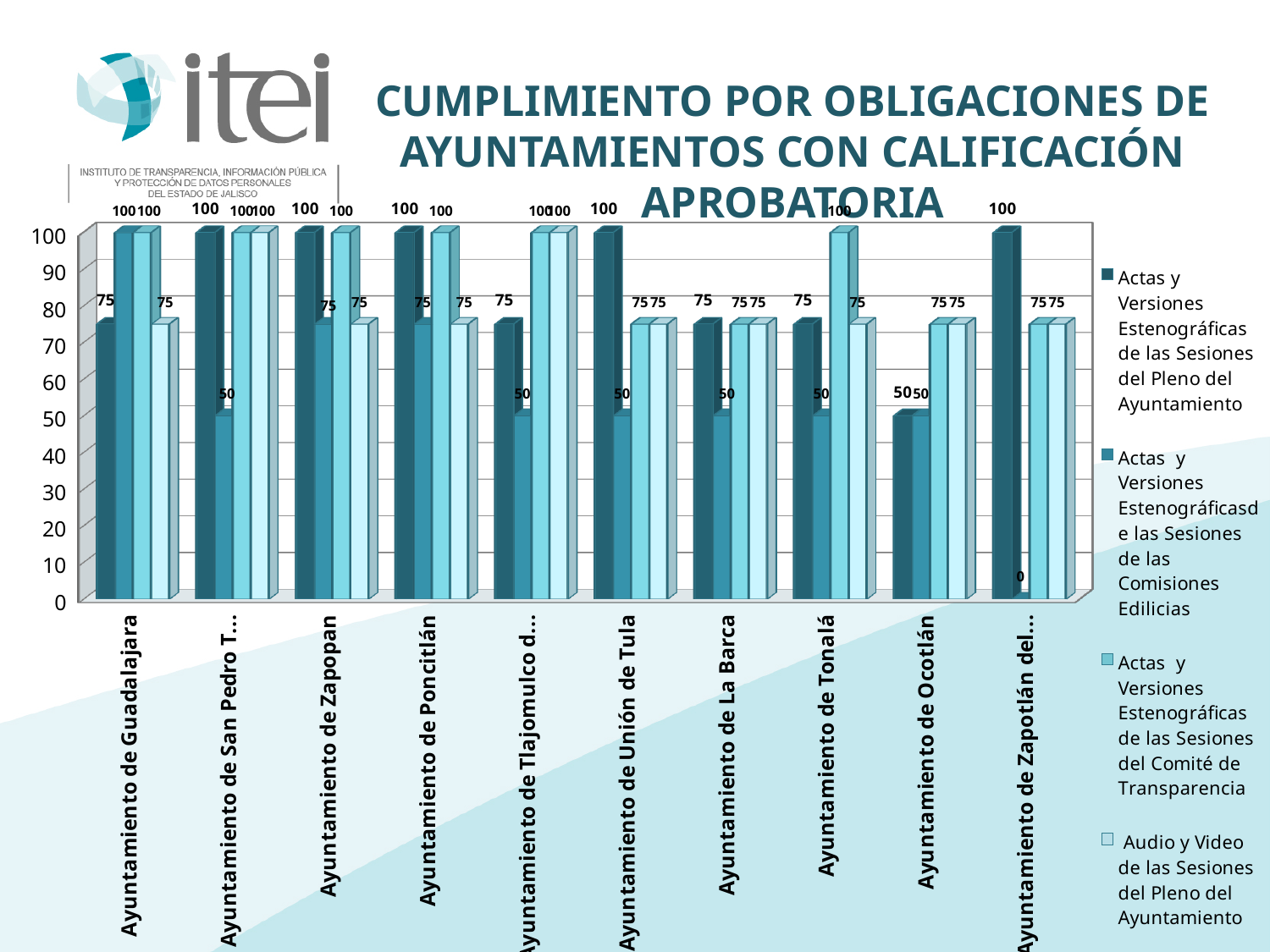
Which ayuntamiento has the lowest value in the series 'Actas y Versiones Estenográficas de las Sesiones de las Comisiones Edilicias'? Ayuntamiento de Zapotlán What type of chart is shown on the slide? bar chart Which is larger for Ayuntamiento de Unión de Tula: the 'Sesiones del Pleno del Ayuntamiento' value or the 'Comisiones Edilicias' value? Sesiones del Pleno del Ayuntamiento What is the value for Ayuntamiento de Ocotlán in the series 'Actas y Versiones Estenográficas de las Sesiones del Pleno del Ayuntamiento'? 50 How many ayuntamientos (categories) are shown on the x axis? 10 What is the title of the chart? CUMPLIMIENTO POR OBLIGACIONES DE AYUNTAMIENTOS CON CALIFICACIÓN APROBATORIA What is the value for Ayuntamiento de Guadalajara in the series 'Actas y Versiones Estenográficas de las Sesiones del Pleno del Ayuntamiento'? 75 What is the value for Ayuntamiento de Tonalá in the series 'Actas y Versiones Estenográficas de las Sesiones del Comité de Transparencia'? 100 What is the difference between the 'Actas y Versiones Estenográficas de las Sesiones del Pleno del Ayuntamiento' value for Ayuntamiento de Zapopan and that for Ayuntamiento de Ocotlán? 50 What is the value for Ayuntamiento de La Barca in the series 'Audio y Video de las Sesiones del Pleno del Ayuntamiento'? 75 What is the value for Ayuntamiento de Zapotlán in the series 'Actas y Versiones Estenográficas de las Sesiones de las Comisiones Edilicias'? 0 How many series does the legend list? 4